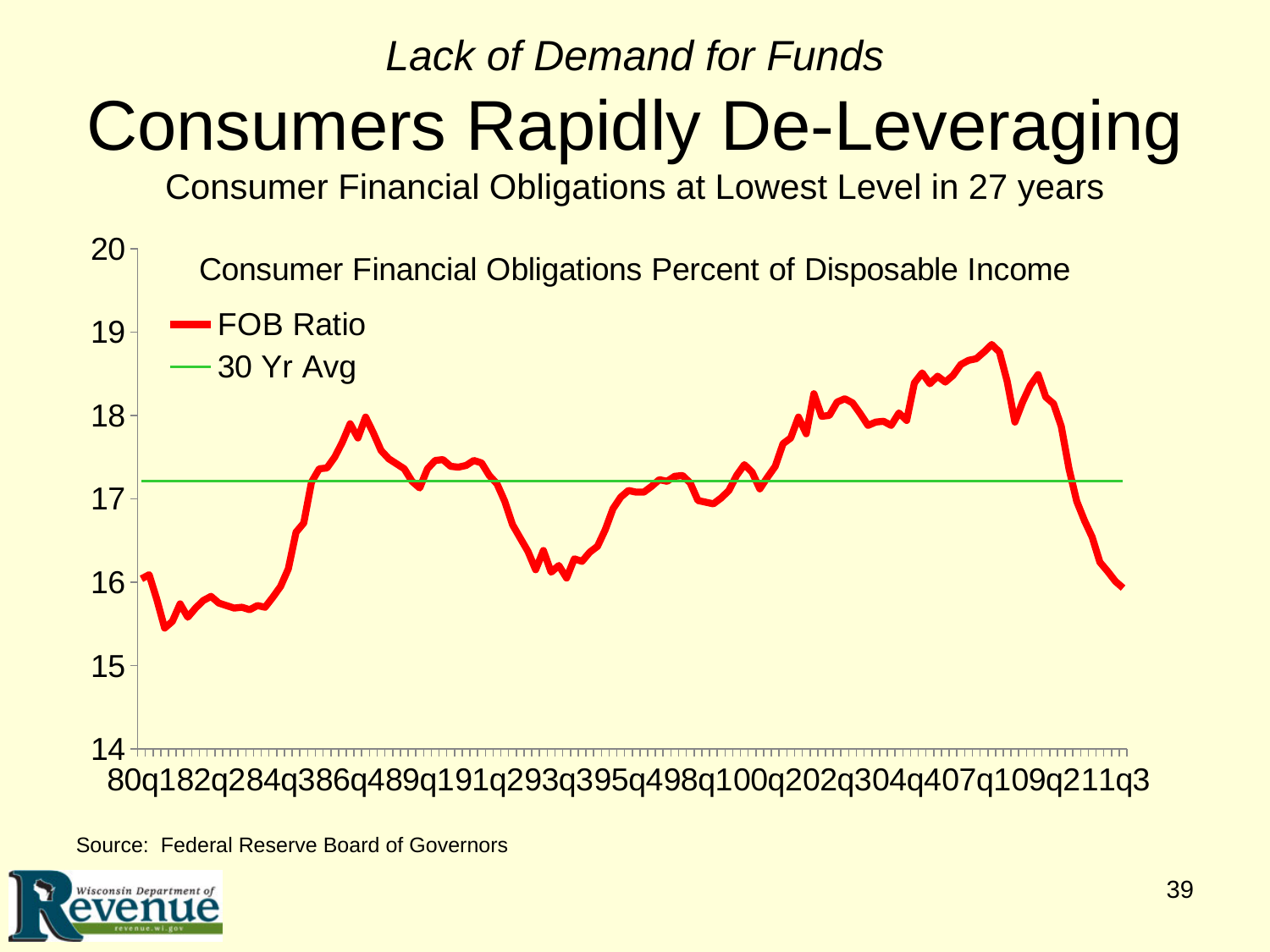
Does the FOB Ratio rise or fall between 07q1 and 11q3? Fall What is the title printed inside the chart area? Consumer Financial Obligations Percent of Disposable Income Is the FOB Ratio value at 07q1 greater or less than 18? greater What kind of chart is shown on the slide? Line chart What are the two series named in the chart legend? FOB Ratio and 30 Yr Avg Is the FOB Ratio value at 93q3 greater or less than 17? less How many series does the chart legend list? 2 Is the FOB Ratio value at 11q3 greater or less than 17? less How many labels are shown on the x axis of the chart? 15